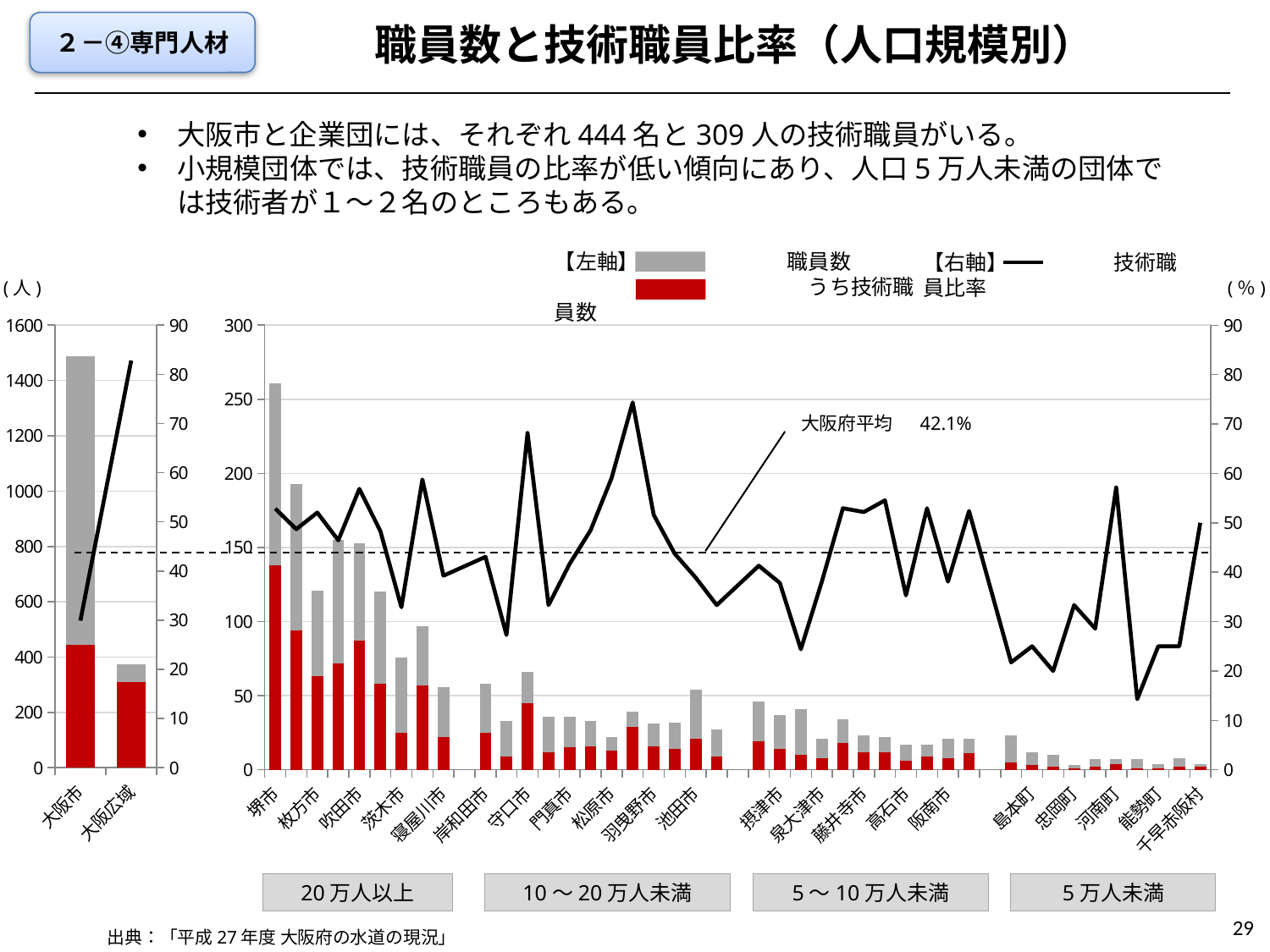
In the left chart, is the 技術職員比率 for 大阪広域 greater or less than 70? greater In the left chart, is the 職員数 value for 大阪広域 greater or less than 600? less In the right chart, which municipality has the highest 職員数? 堺市 In the right chart, what is the 大阪府平均 value shown by the dashed line? 42.1% In the right chart, which has the larger 職員数, 堺市 or 枚方市? 堺市 What kind of chart is the large chart on the right of the slide? A bar chart combined with a line In the left chart, is the 職員数 value for 大阪市 greater or less than 1400? greater How many population-size groups are labelled below the right chart? 4 In the left chart, which has the larger 職員数, 大阪市 or 大阪広域? 大阪市